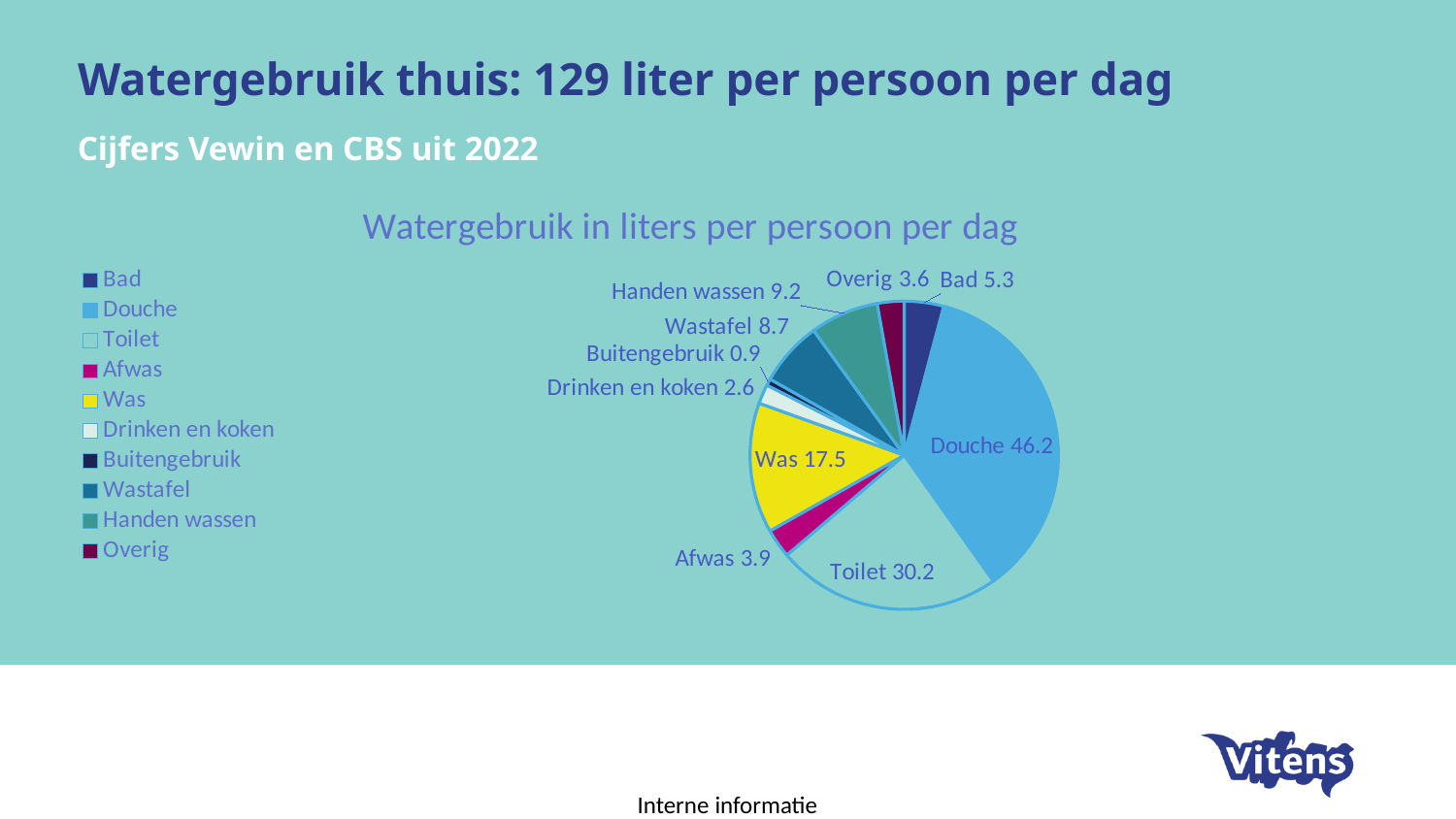
Which category has the largest slice in the pie chart? Douche What kind of chart is shown on the slide? Pie chart How many categories are shown in the pie chart? 10 What is the value for Toilet in the pie chart? 30.2 Which category has the smallest slice in the pie chart? Buitengebruik Which is larger, the value for Handen wassen or the value for Wastafel? Handen wassen What is the value for Handen wassen in the pie chart? 9.2 What is the title of the chart? Watergebruik in liters per persoon per dag What is the value for Douche in the pie chart? 46.2 What is the value for Was in the pie chart? 17.5 What is the value for Buitengebruik in the pie chart? 0.9 What is the difference between the values for Douche and Toilet? 16